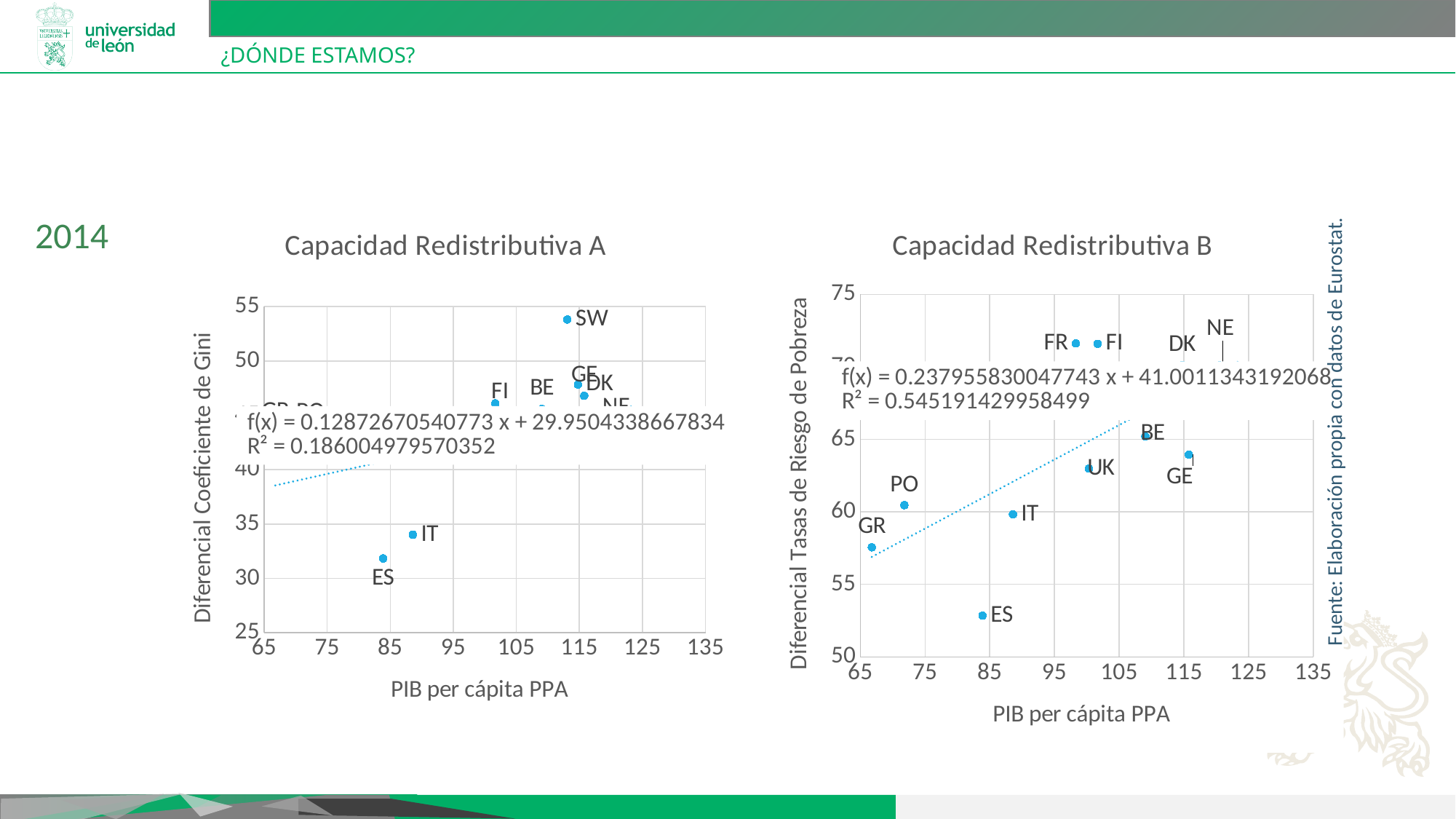
In the chart 'Capacidad Redistributiva A', which country has the highest Diferencial Coeficiente de Gini? SW What is the x-axis title of the chart 'Capacidad Redistributiva B'? PIB per cápita PPA In the chart 'Capacidad Redistributiva B', which has the higher Diferencial Tasas de Riesgo de Pobreza, UK or GR? UK In the chart 'Capacidad Redistributiva A', which has the higher Diferencial Coeficiente de Gini, SW or IT? SW In the chart 'Capacidad Redistributiva B', is the value for ES greater or less than 55? less In the chart 'Capacidad Redistributiva B', is the value for FR greater or less than 70? greater In the chart 'Capacidad Redistributiva B', which country has the lowest Diferencial Tasas de Riesgo de Pobreza? ES In the chart 'Capacidad Redistributiva A', is the Diferencial Coeficiente de Gini for ES greater or less than 35? less In the chart 'Capacidad Redistributiva A', which country has the lowest Diferencial Coeficiente de Gini? ES In the chart 'Capacidad Redistributiva A', what R² value is printed for the trend line? R² = 0.186004979570352 What kind of chart is 'Capacidad Redistributiva A'? Scatter chart